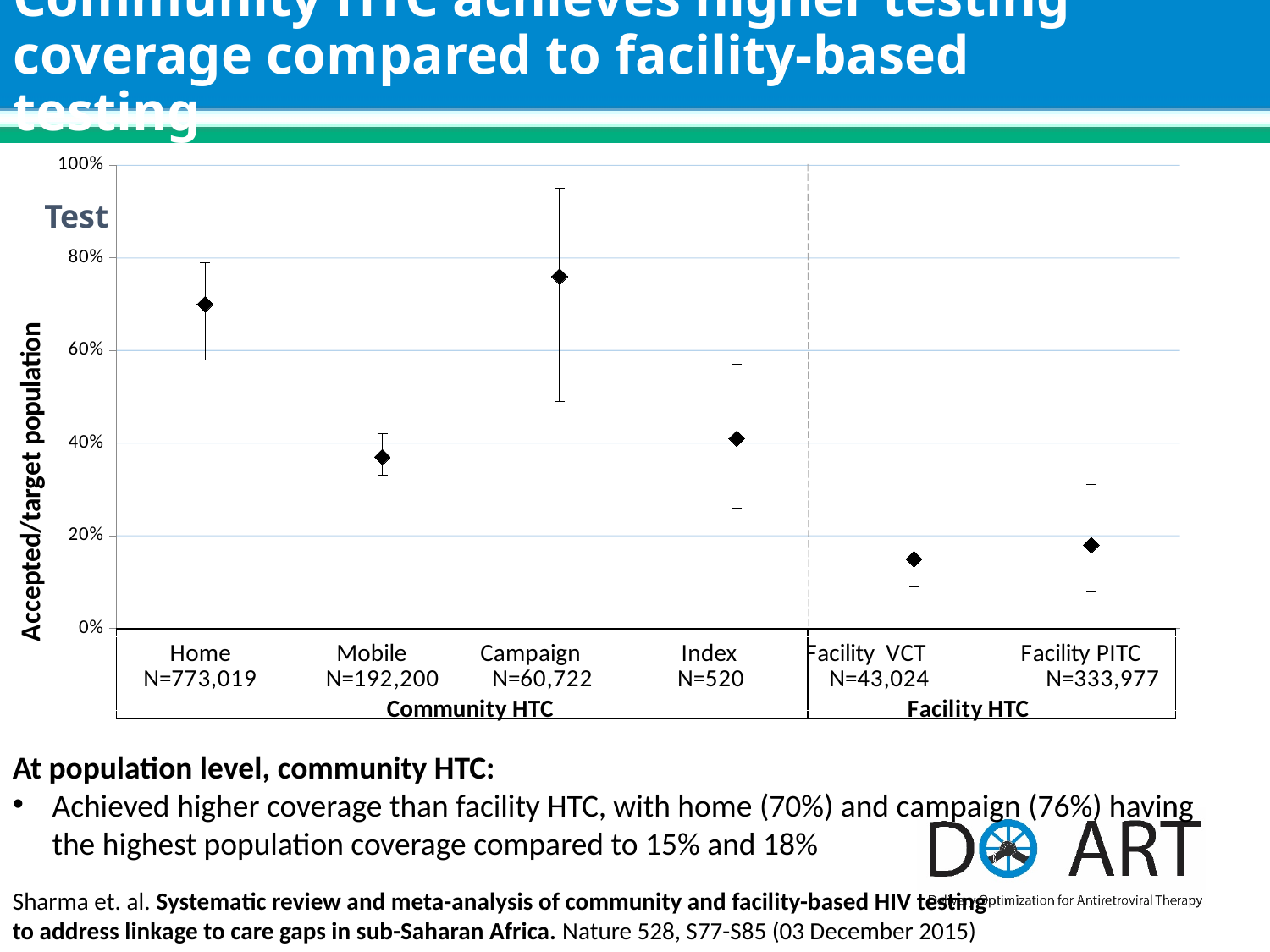
What is the testing coverage value for Facility PITC? 18% Which category has the highest coverage? Campaign Is the value for Index greater or less than 20%? greater What is the testing coverage value for Facility VCT? 15% What is the label of the y axis? Accepted/target population What is the testing coverage value for Home? 70% Is the value for Mobile greater or less than 40%? less Which has higher coverage, Home or Facility PITC? Home Which category has the lowest coverage? Facility VCT What is the difference in coverage between Campaign and Home? 6 percentage points What is the testing coverage value for Campaign? 76% How many testing categories are shown on the x axis? 6